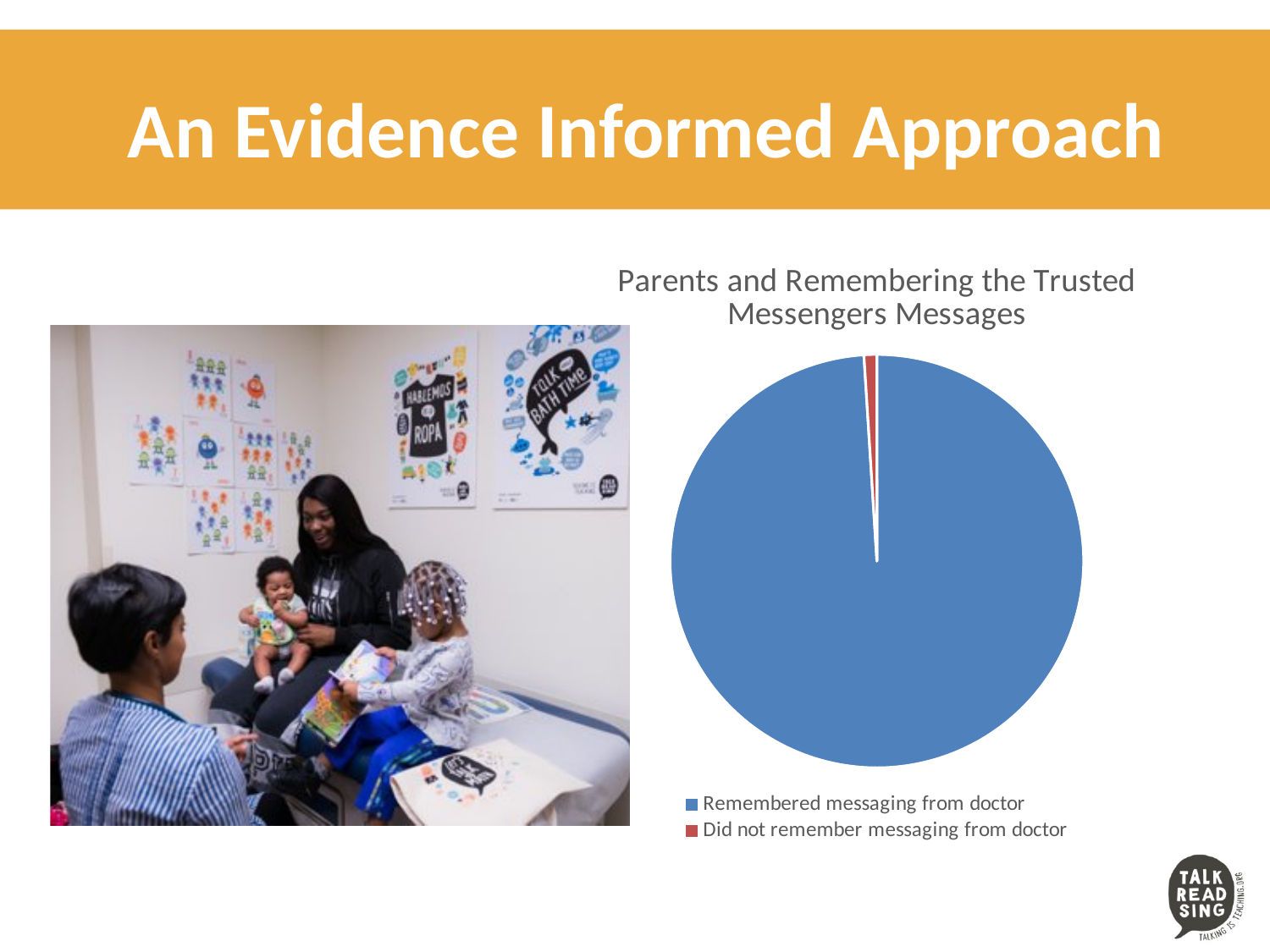
Which category has the smallest slice of the pie chart? Did not remember messaging from doctor How many slices does the pie chart have? 2 What colour is the slice for 'Did not remember messaging from doctor' in the pie chart? red What is the title of the chart on the slide? Parents and Remembering the Trusted Messengers Messages Which category has the largest slice of the pie chart? Remembered messaging from doctor How many entries does the chart's legend list? 2 What kind of chart is shown on the slide? pie chart Which is larger in the pie chart: the slice for 'Remembered messaging from doctor' or the slice for 'Did not remember messaging from doctor'? Remembered messaging from doctor